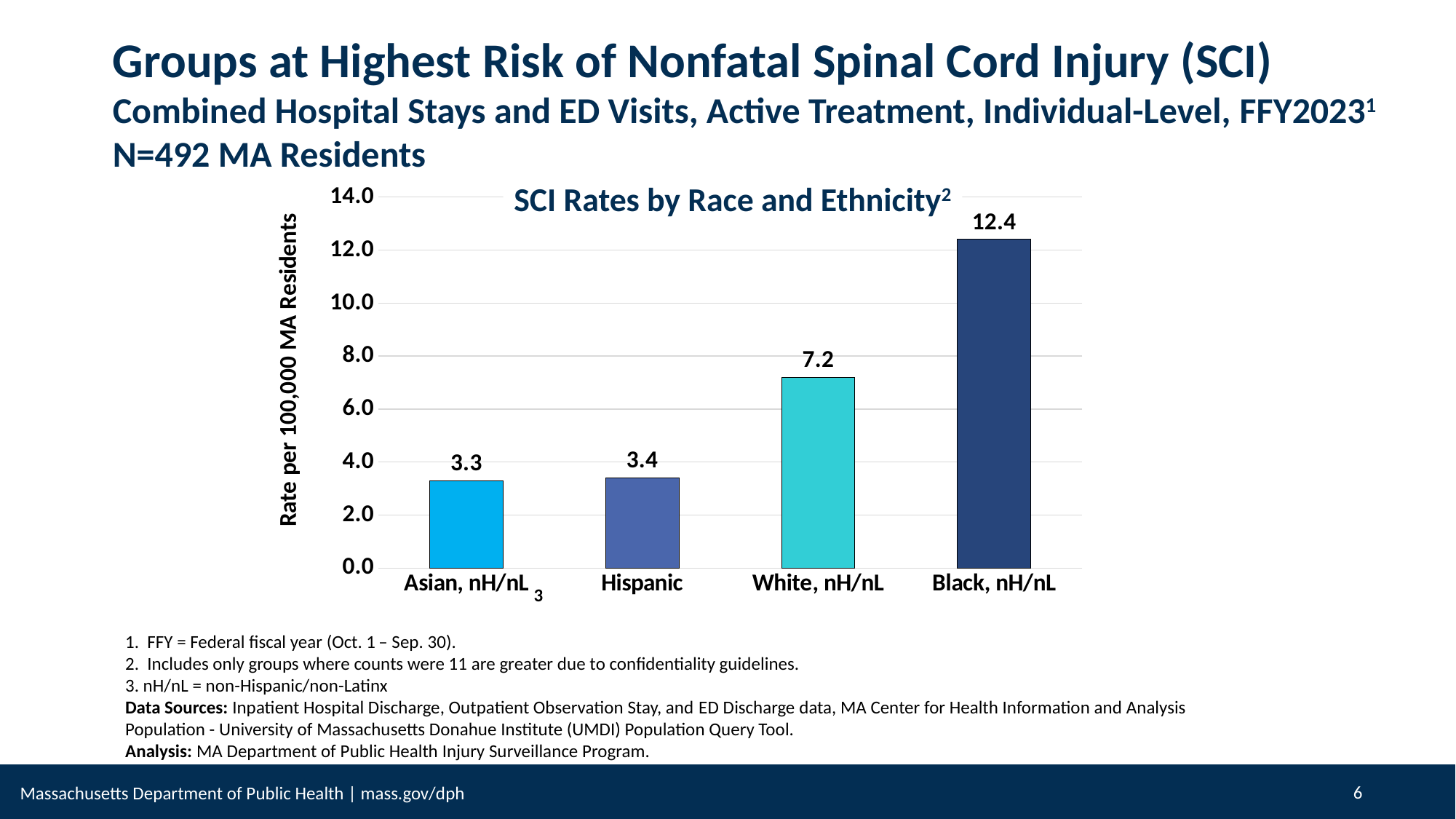
What is the title of the chart? SCI Rates by Race and Ethnicity What is the SCI rate for White, nH/nL residents? 7.2 Is the SCI rate for Black, nH/nL residents greater or less than 10.0? greater What kind of chart is shown on the slide? Bar chart Which group has the lowest SCI rate? Asian, nH/nL How many race and ethnicity groups are shown in the chart? 4 What is the SCI rate for Black, nH/nL residents? 12.4 Which has a higher SCI rate, White, nH/nL or Hispanic? White, nH/nL What is the difference between the SCI rates for Black, nH/nL and White, nH/nL residents? 5.2 What is the SCI rate for Hispanic residents? 3.4 Which group has the highest SCI rate? Black, nH/nL What is the SCI rate for Asian, nH/nL residents? 3.3